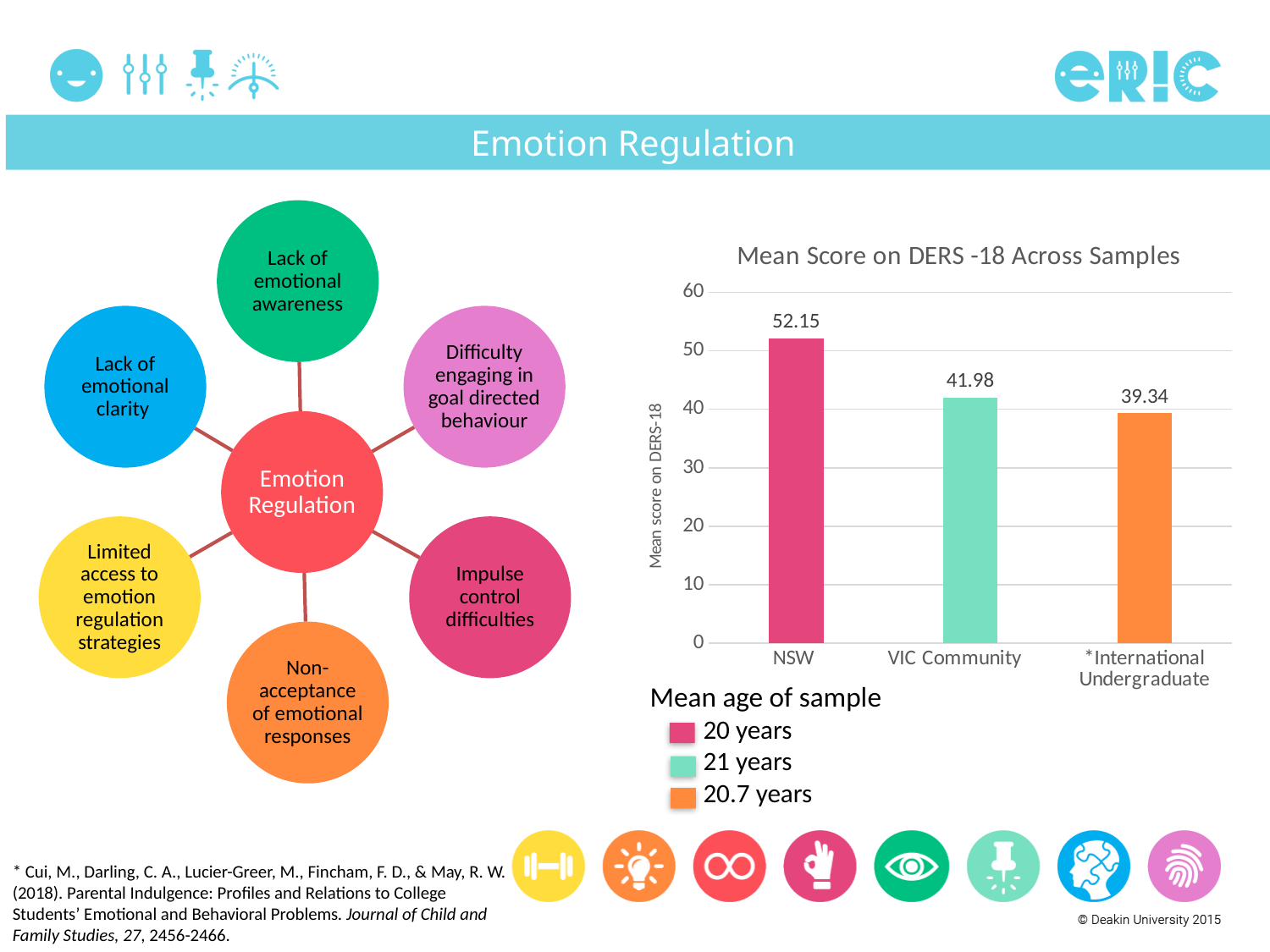
What is the title of the chart on the slide? Mean Score on DERS -18 Across Samples What is the difference between the mean DERS-18 scores of the NSW and VIC Community samples? 10.17 What is the mean score on DERS-18 for the NSW sample? 52.15 Which sample has the highest mean score on DERS-18? NSW What is the mean score on DERS-18 for the VIC Community sample? 41.98 How many samples are shown in the bar chart? 3 What type of chart is used to show the mean scores on DERS-18? Bar chart What is the mean score on DERS-18 for the International Undergraduate sample? 39.34 Which sample has the lowest mean score on DERS-18? International Undergraduate What is the difference between the mean DERS-18 scores of the VIC Community and International Undergraduate samples? 2.64 Is the mean DERS-18 score for NSW greater or less than 50? greater Which has a higher mean DERS-18 score, NSW or International Undergraduate? NSW